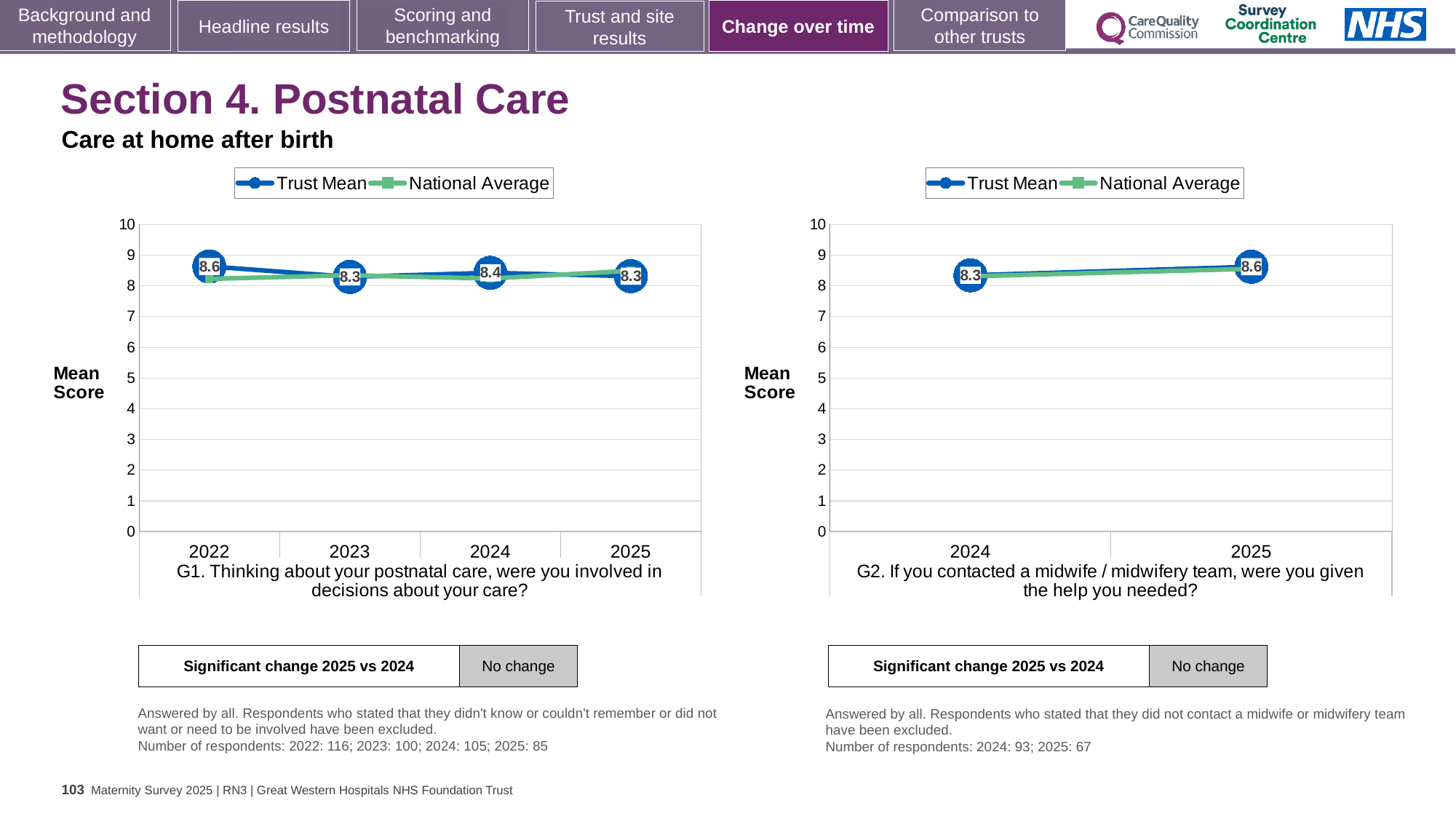
What kind of chart is the G2 chart (right)? line chart On the G1 chart (left), what is the Trust Mean for 2025? 8.3 On the G1 chart (left), what is the Trust Mean for 2024? 8.4 On the G1 chart (left), which year has the highest Trust Mean? 2022 On the G1 chart (left), what is the difference between the Trust Mean for 2022 and 2025? 0.3 On the G2 chart (right), what is the Trust Mean for 2024? 8.3 On the G2 chart (right), what is the Trust Mean for 2025? 8.6 On the G1 chart (left), what is the Trust Mean for 2022? 8.6 On the G1 chart (left), how many years are shown on the x axis? 4 On the G2 chart (right), is the Trust Mean for 2025 greater or less than 8? greater How many series does the legend of the G1 chart (left) list? 2 On the G2 chart (right), does the Trust Mean rise or fall from 2024 to 2025? rise